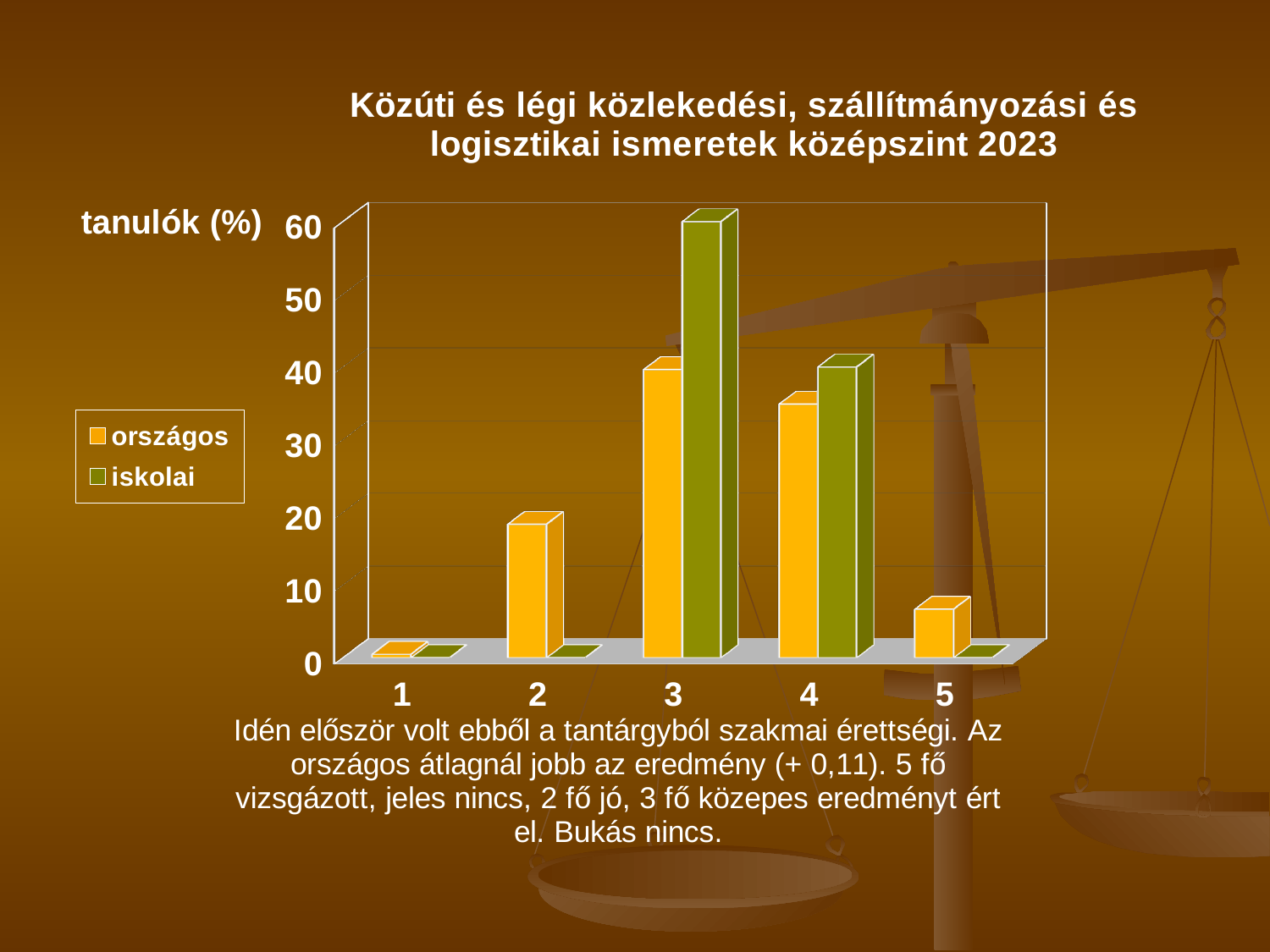
What kind of chart is shown on the slide? bar chart How many series does the legend list? 2 Is the országos value for category 4 greater or less than 30? greater For category 3, which series has the larger value, országos or iskolai? iskolai Which category has the highest value for the iskolai series? 3 Which category has the lowest value for the országos series? 1 Is the országos value for category 2 greater or less than 30? less What is the label of the vertical axis? tanulók (%) For the országos series, which category has the larger value, 2 or 4? 4 How many categories are shown on the x axis? 5 Is the iskolai value for category 3 greater or less than 50? greater Which category has the highest value for the országos series? 3